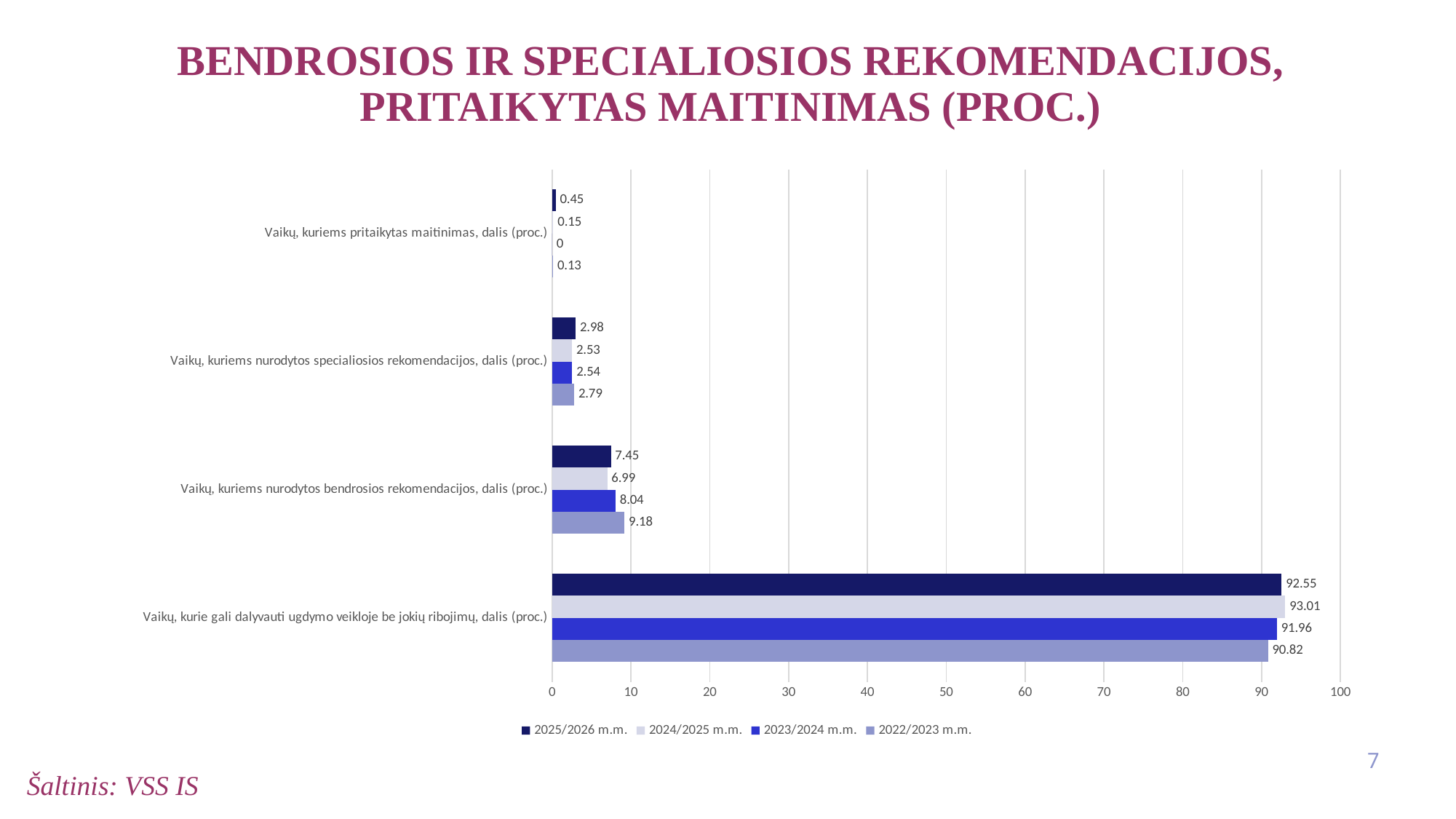
What is the value for 2024/2025 m.m. in the category "Vaikų, kuriems nurodytos specialiosios rekomendacijos, dalis (proc.)"? 2.53 What is the difference between the 2022/2023 m.m. and 2025/2026 m.m. values for "Vaikų, kuriems nurodytos bendrosios rekomendacijos, dalis (proc.)"? 1.73 Which series has the highest value in the category "Vaikų, kurie gali dalyvauti ugdymo veikloje be jokių ribojimų, dalis (proc.)"? 2024/2025 m.m. What is the value for 2023/2024 m.m. in the category "Vaikų, kuriems pritaikytas maitinimas, dalis (proc.)"? 0 How many series does the legend list? 4 Which series has the lowest value in the category "Vaikų, kuriems nurodytos bendrosios rekomendacijos, dalis (proc.)"? 2024/2025 m.m. What is the value for 2025/2026 m.m. in the category "Vaikų, kurie gali dalyvauti ugdymo veikloje be jokių ribojimų, dalis (proc.)"? 92.55 How many categories are shown on the chart? 4 What is the value for 2022/2023 m.m. in the category "Vaikų, kuriems nurodytos bendrosios rekomendacijos, dalis (proc.)"? 9.18 Which is larger for "Vaikų, kuriems nurodytos specialiosios rekomendacijos, dalis (proc.)": the 2025/2026 m.m. value or the 2022/2023 m.m. value? 2025/2026 m.m. What is the source cited at the bottom of the slide? VSS IS What kind of chart is shown on the slide? bar chart